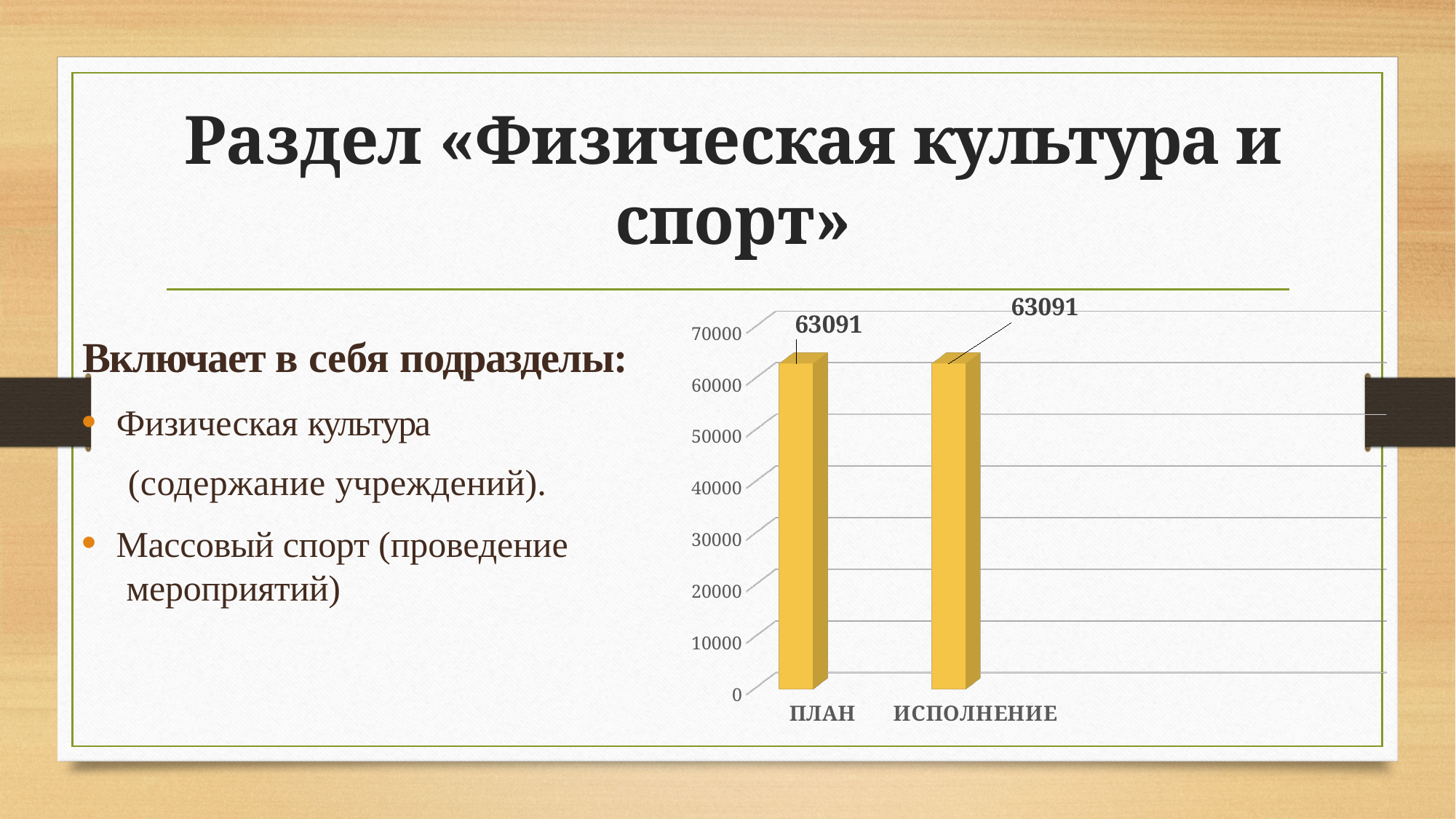
Are the values for ПЛАН and ИСПОЛНЕНИЕ equal? yes What is the difference between the values for ПЛАН and ИСПОЛНЕНИЕ? 0 What colour are the bars in the chart? yellow Is the value for ИСПОЛНЕНИЕ greater or less than 70000? less What kind of chart is shown on the slide? bar chart Is the value for ПЛАН greater or less than 60000? greater What is the value for ПЛАН? 63091 What is the value for ИСПОЛНЕНИЕ? 63091 How many categories are shown on the x axis of the chart? 2 What is the highest value shown on the vertical axis of the chart? 70000